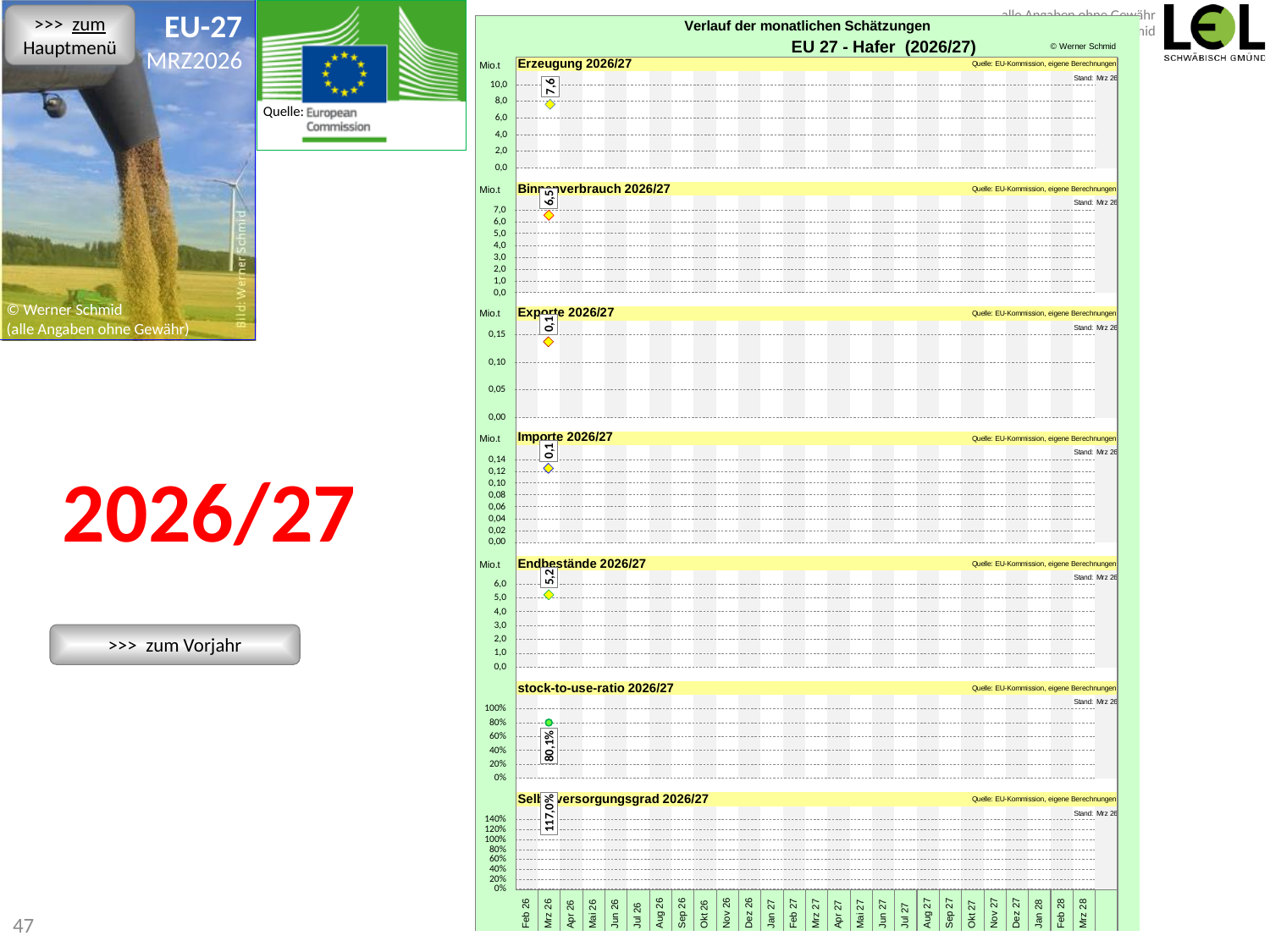
How many data points are plotted in the 'Erzeugung 2026/27' chart? 1 In the 'Endbestände 2026/27' chart, what value is plotted for Mrz 26? 5,2 In the 'Exporte 2026/27' chart, what value is plotted for Mrz 26? 0,1 In the 'stock-to-use-ratio 2026/27' chart, what value is plotted for Mrz 26? 80,1% In the 'Selbstversorgungsgrad 2026/27' chart, what value is plotted for Mrz 26? 117,0% In the 'Endbestände 2026/27' chart, is the value for Mrz 26 greater or less than 6,0? less In the 'Erzeugung 2026/27' chart, what value is plotted for Mrz 26? 7,6 In the 'Binnenverbrauch 2026/27' chart, what value is plotted for Mrz 26? 6,5 What unit is shown on the y axis of the 'Endbestände 2026/27' chart? Mio.t What is the difference between the Mrz 26 value in the 'Erzeugung 2026/27' chart and the Mrz 26 value in the 'Binnenverbrauch 2026/27' chart? 1,1 In the 'Importe 2026/27' chart, what value is plotted for Mrz 26? 0,1 Which is larger for Mrz 26: the value in the 'Erzeugung 2026/27' chart or the value in the 'Binnenverbrauch 2026/27' chart? Erzeugung 2026/27